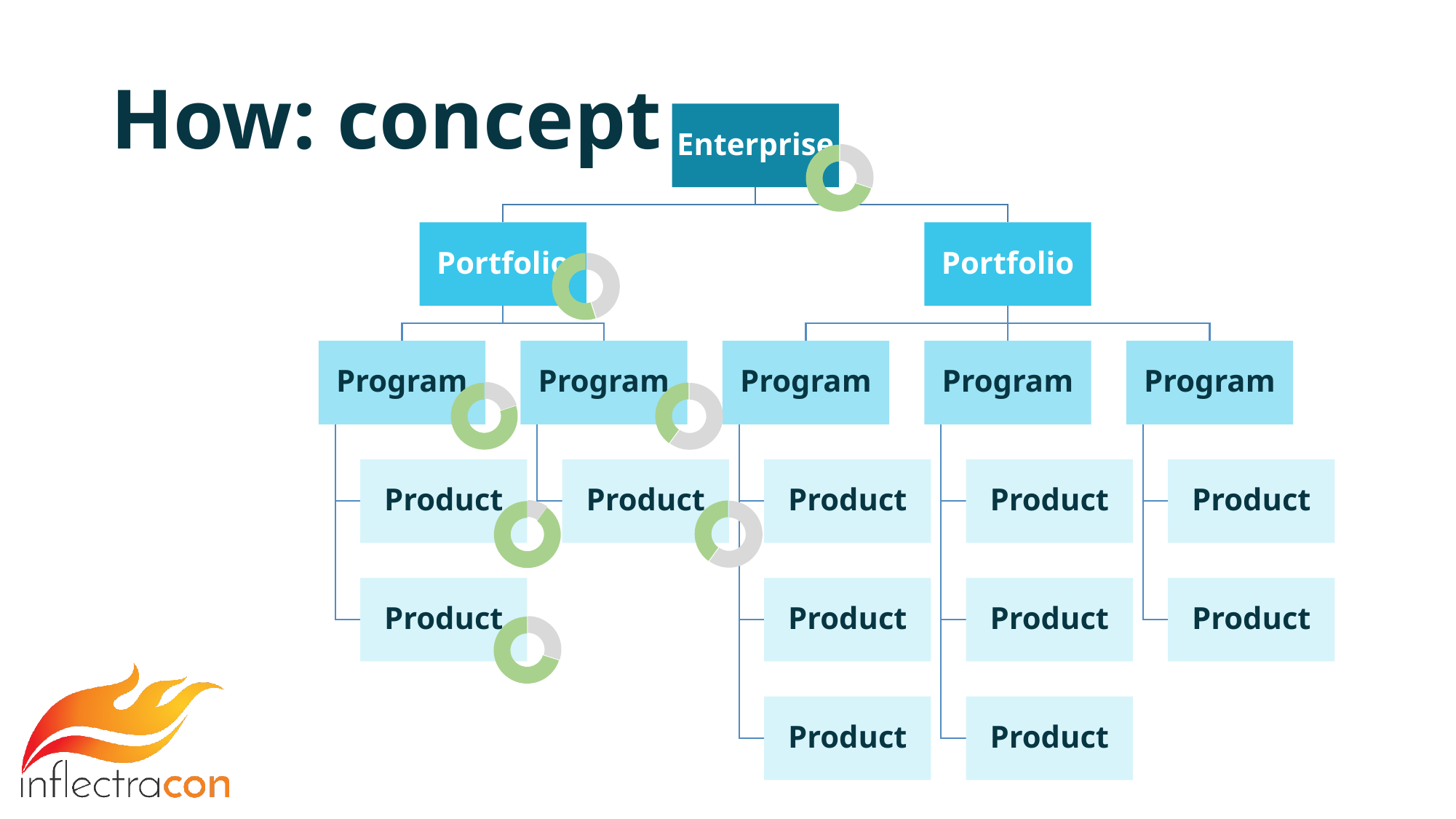
How many small donut charts are shown on the slide? 7 Which has a larger green share: the donut chart next to the Enterprise box or the donut chart next to the second Program box from the left? the donut chart next to the Enterprise box What kind of chart are the small circular charts overlaid on the hierarchy diagram? donut chart What two colours are used in the small donut charts? green and grey